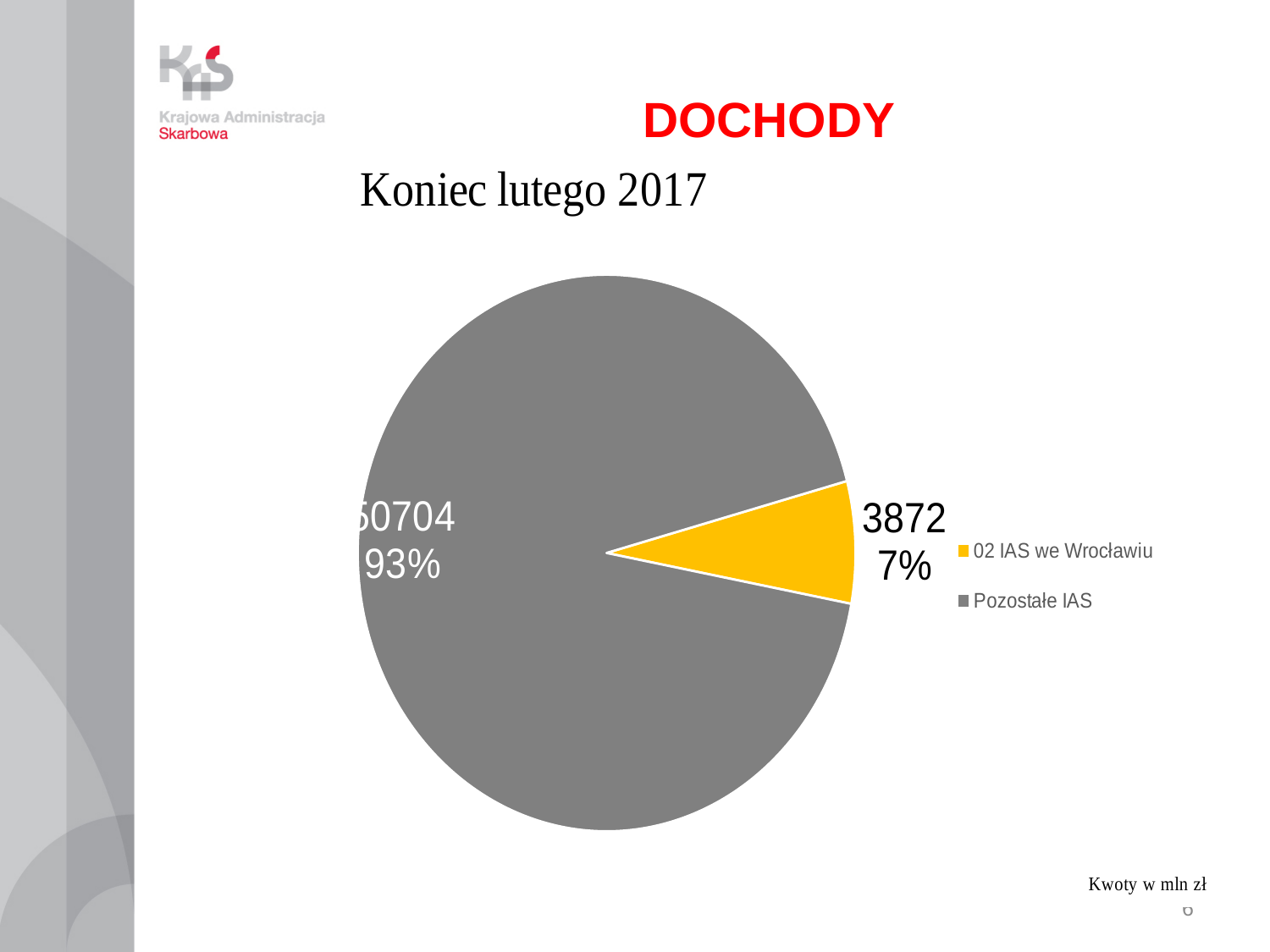
What kind of chart is shown on the slide? Pie chart How many slices does the pie chart have? 2 Which category has the smallest slice of the pie? 02 IAS we Wrocławiu What is the value shown for 02 IAS we Wrocławiu? 3872 What share of the pie does 02 IAS we Wrocławiu represent? 7% What share of the pie does Pozostałe IAS represent? 93% What colour is the slice for 02 IAS we Wrocławiu? Yellow Which is larger, the slice for 02 IAS we Wrocławiu or the slice for Pozostałe IAS? Pozostałe IAS How many entries does the legend list? 2 Which category has the largest slice of the pie? Pozostałe IAS